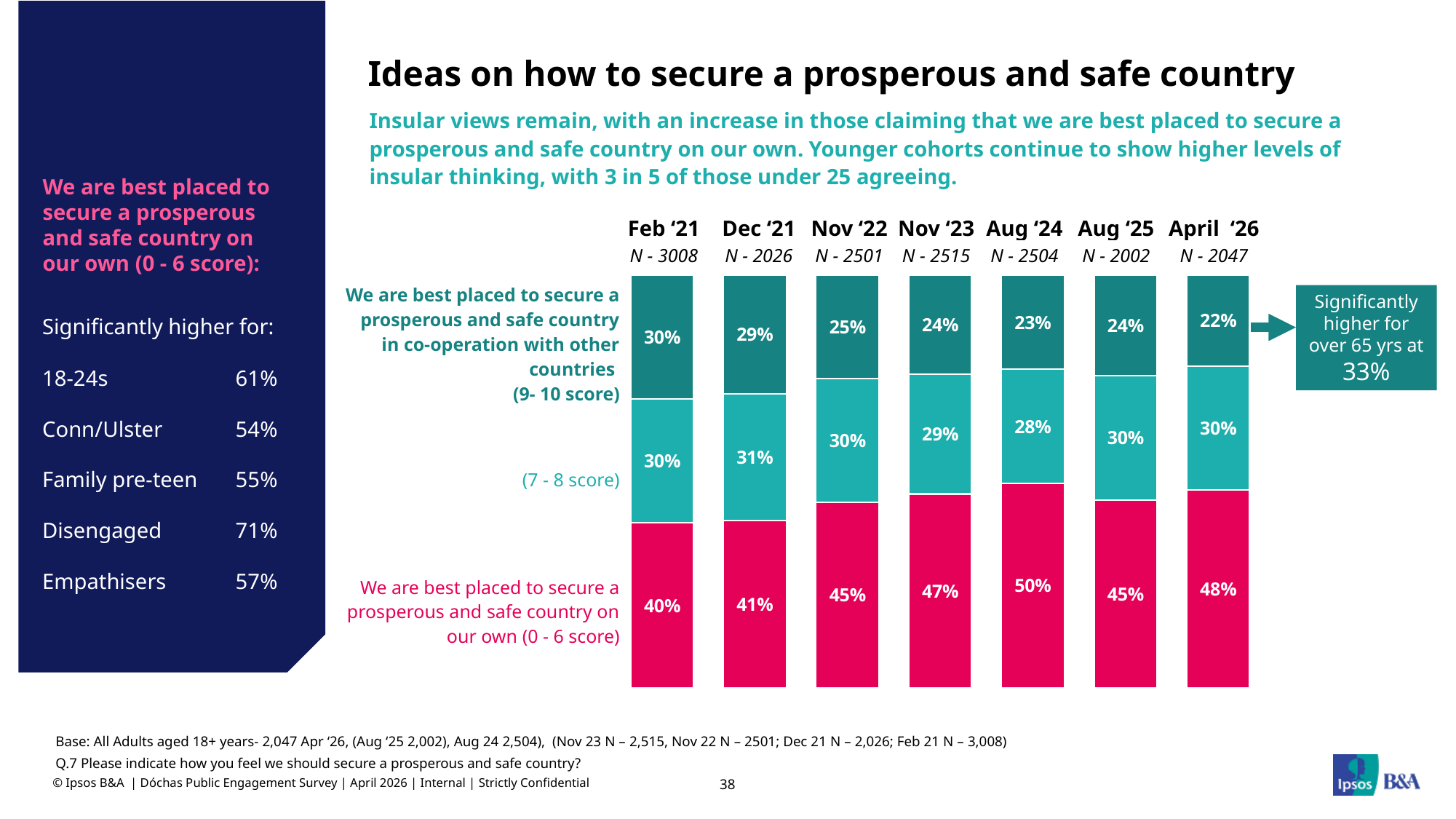
Which is larger: the 0-6 score share in Nov '23 or in Aug '25? Nov '23 How does the 9-10 score (co-operation) share change from Feb '21 to April '26? It falls What percentage gave a 9-10 score (co-operation with other countries) in Feb '21? 30% In which wave was the 9-10 score (co-operation) share lowest? April '26 What type of chart is used to show the scores across waves? Stacked bar chart What percentage gave a 0-6 score (best placed on our own) in April '26? 48% In which wave was the 0-6 score (on our own) share highest? Aug '24 How many survey waves are shown in the chart? 7 According to the callout, what is the 9-10 score share for those over 65 years in April '26? 33% What is the difference between the 0-6 score share in Aug '24 and in Feb '21? 10 percentage points What percentage gave a 7-8 score in Dec '21? 31% What is the sample size (N) for the Nov '22 wave? 2501